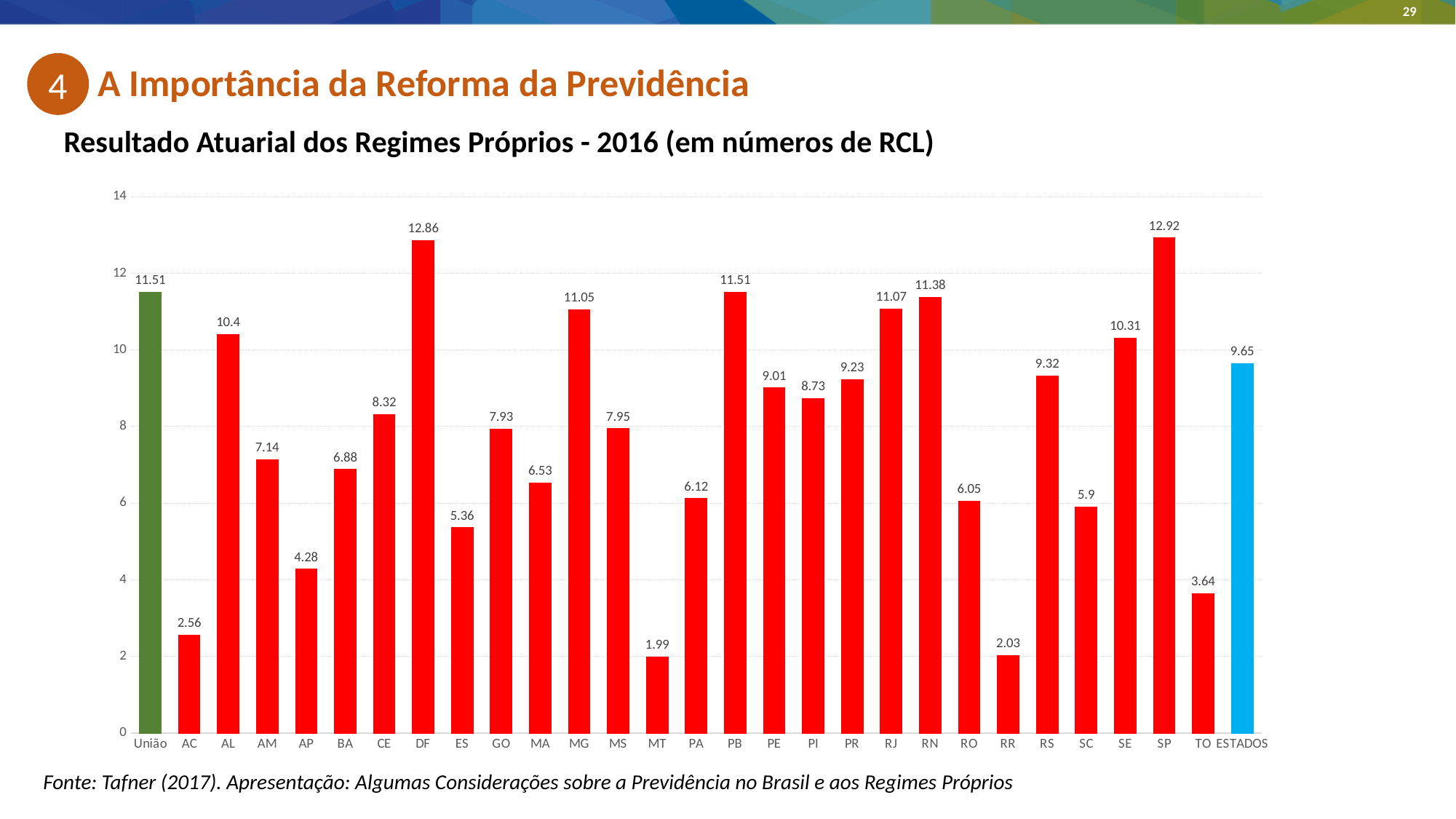
What kind of chart is shown on the slide? Bar chart What is the value for RR? 2.03 What is the value for ESTADOS? 9.65 Which category has the highest value? SP How many bars are plotted in the chart? 29 What is the value for União? 11.51 Is the value for RS greater or less than 10? less Which is larger, the value for PB or the value for PE? PB What is the difference between the values for SP and DF? 0.06 What is the value for DF? 12.86 Which category has the lowest value? MT What is the difference between the values for União and AC? 8.95